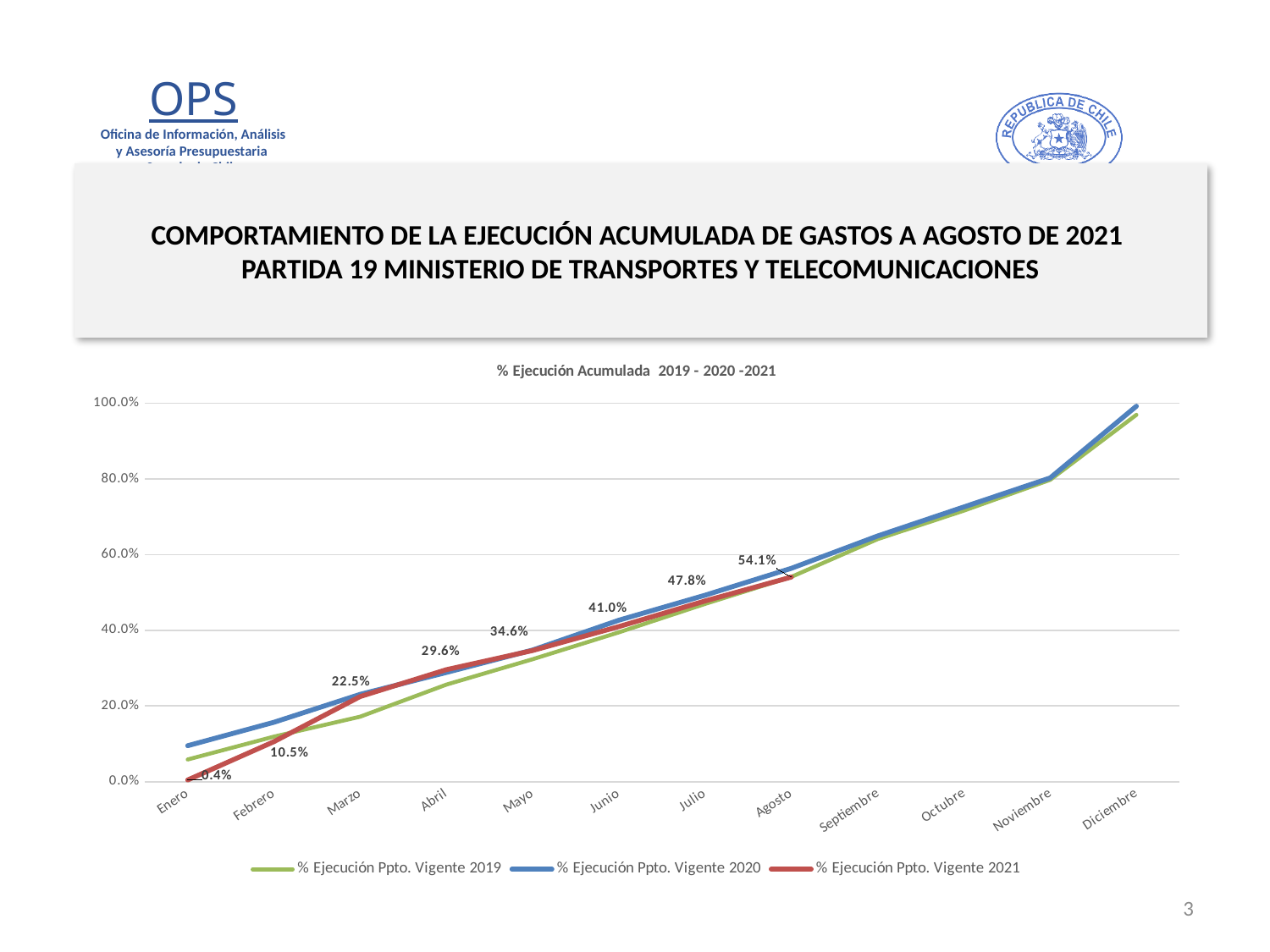
Which month has the lowest value for % Ejecución Ppto. Vigente 2021? Enero What is the value of % Ejecución Ppto. Vigente 2021 for Enero? 0.4% Is the value of % Ejecución Ppto. Vigente 2020 for Diciembre greater or less than 80.0%? greater What is the difference between the % Ejecución Ppto. Vigente 2021 values for Agosto and Julio? 6.3% How many months are shown along the x axis? 12 How many series does the legend list? 3 What is the value of % Ejecución Ppto. Vigente 2021 for Marzo? 22.5% What is the value of % Ejecución Ppto. Vigente 2021 for Agosto? 54.1% What is the value of % Ejecución Ppto. Vigente 2021 for Junio? 41.0% Which month has the highest value for % Ejecución Ppto. Vigente 2021? Agosto Do the values of % Ejecución Ppto. Vigente 2021 rise or fall from Enero to Agosto? rise What kind of chart is shown on the slide? line chart